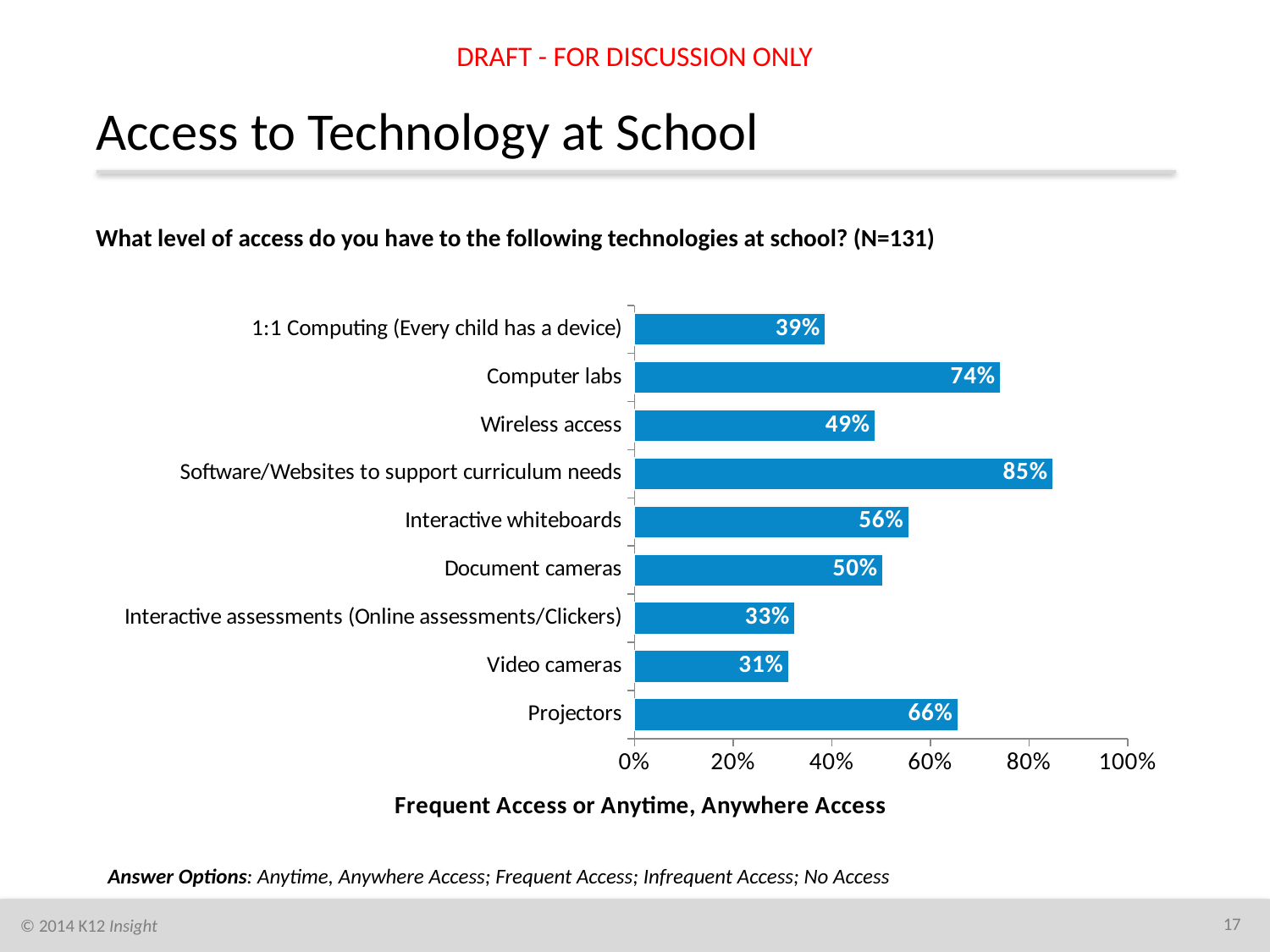
What is the value shown for Video cameras? 31% Which technology has the highest percentage of frequent or anytime, anywhere access? Software/Websites to support curriculum needs What percentage of respondents reported frequent or anytime, anywhere access to Computer labs? 74% What is the value shown for Interactive whiteboards? 56% Which technology has the lowest percentage of frequent or anytime, anywhere access? Video cameras What is the label shown beneath the chart's x axis? Frequent Access or Anytime, Anywhere Access What is the difference in percentage points between Computer labs and Projectors? 8 What type of chart is shown on the slide? Bar chart What is the difference in percentage points between Software/Websites to support curriculum needs and 1:1 Computing (Every child has a device)? 46 Which has a higher value, Wireless access or Document cameras? Document cameras How many technologies are listed in the chart? 9 Is the value for Projectors greater or less than 60%? greater